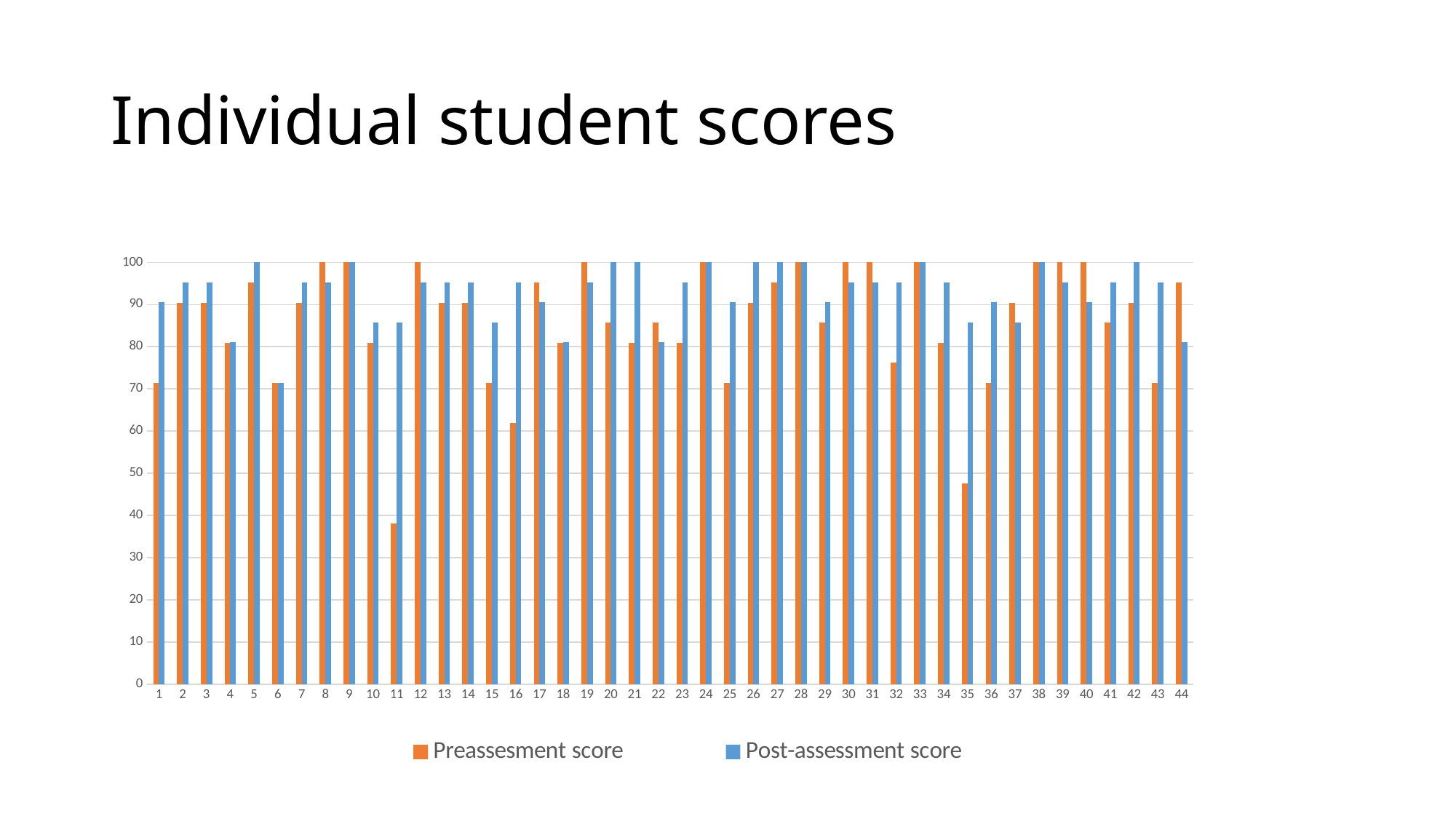
For student 32, which is larger, the Preassesment score or the Post-assessment score? Post-assessment score What is the Preassesment score for student 28? 100 Which student has the lowest Preassesment score? 11 Is the Preassesment score for student 11 greater or less than 40? less Is the Preassesment score for student 35 greater or less than 50? less Is the Post-assessment score for student 16 greater or less than 90? greater What is the Post-assessment score for student 9? 100 How many series does the legend list? 2 How many students are shown on the x axis? 44 For student 11, which is larger, the Preassesment score or the Post-assessment score? Post-assessment score What kind of chart is shown on the slide? bar chart What colour represents the Post-assessment score in the legend? blue